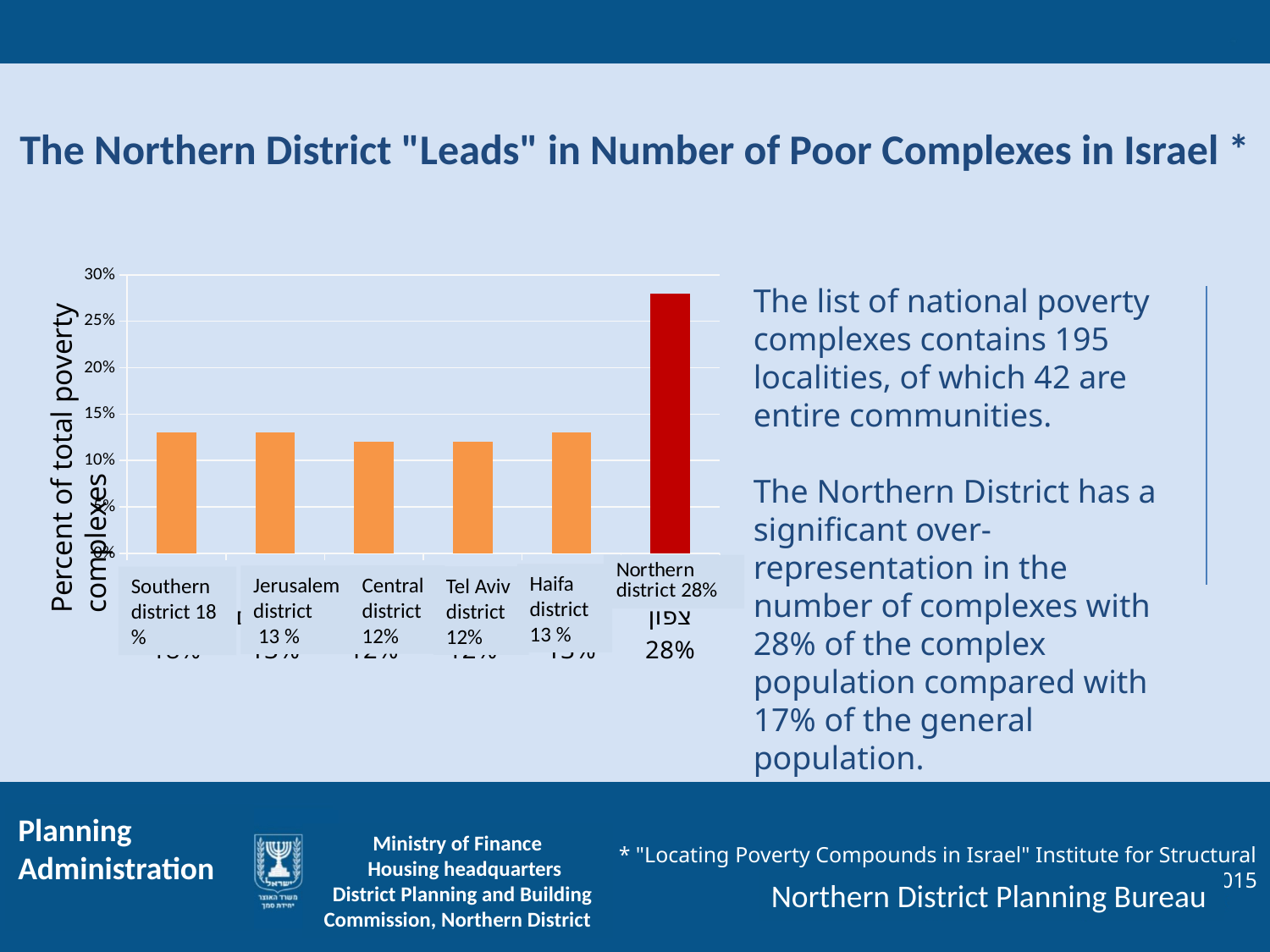
What is the value for the Jerusalem district? 13% What is the difference between the Northern district and the Central district values? 16 percentage points What is the value for the Haifa district? 13% What is the value for the Tel Aviv district? 12% What is the value for the Central district? 12% What colour is the bar for the Northern district? Red Which district has the highest percent of total poverty complexes? Northern district What kind of chart is shown on the slide? Bar chart What is the value for the Northern district? 28% Is the value for the Northern district greater or less than 25%? greater Which is larger, the value for the Northern district or the Haifa district? Northern district How many districts are shown in the chart? 6